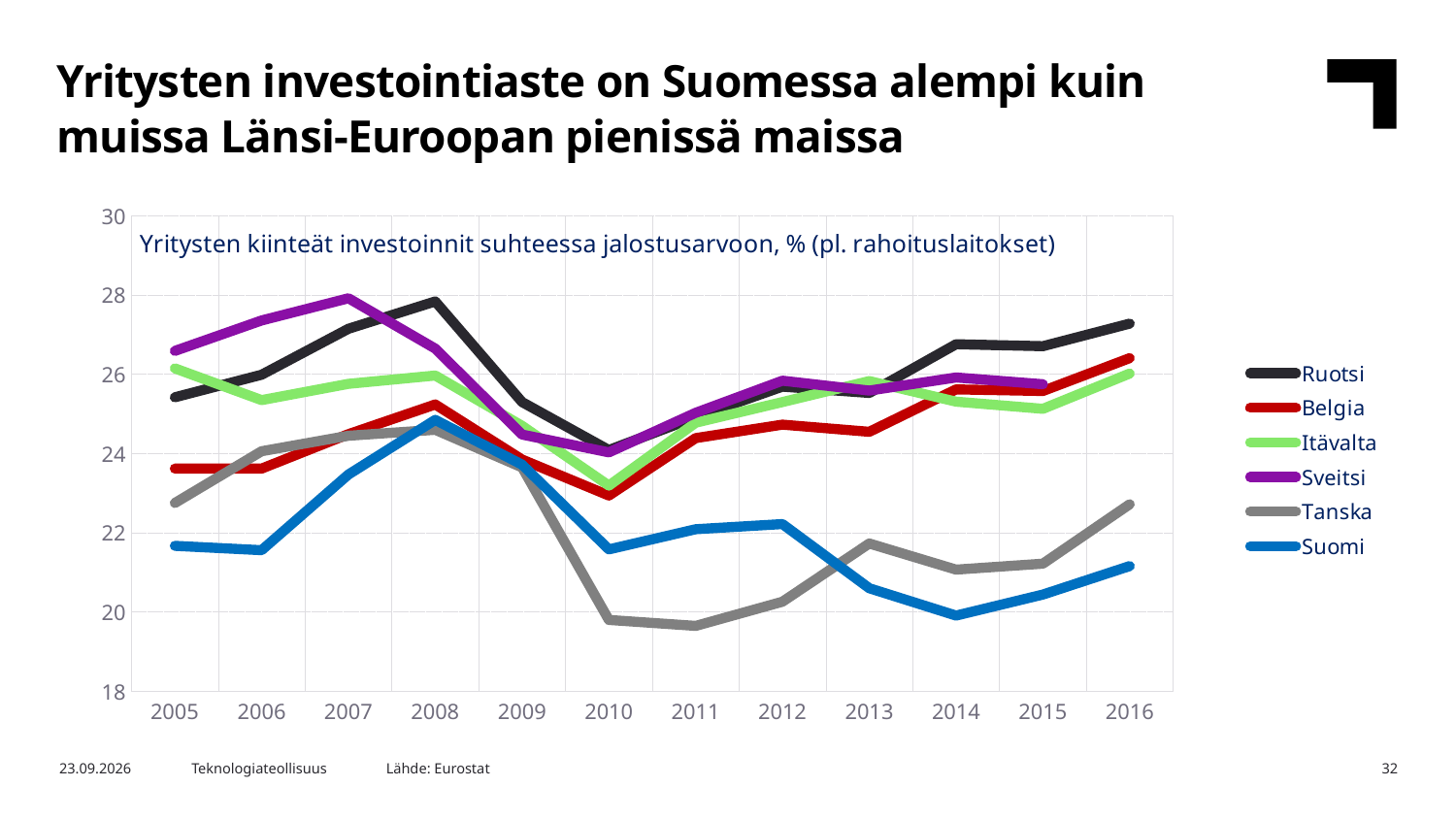
In 2005, which is larger: Ruotsi or Suomi? Ruotsi Which series has the highest value in 2016? Ruotsi Which series is drawn in blue? Suomi Which series has the lowest value in 2010? Tanska Which series has the lowest value in 2016? Suomi How many years are shown on the x axis? 12 Is the value for Suomi in 2010 greater or less than 20? greater What type of chart is shown on the slide? line chart What is the title printed inside the chart area? Yritysten kiinteät investoinnit suhteessa jalostusarvoon, % (pl. rahoituslaitokset) Does the value for Suomi rise or fall from 2012 to 2014? fall Is the value for Ruotsi in 2016 greater or less than 26? greater How many series does the legend list? 6